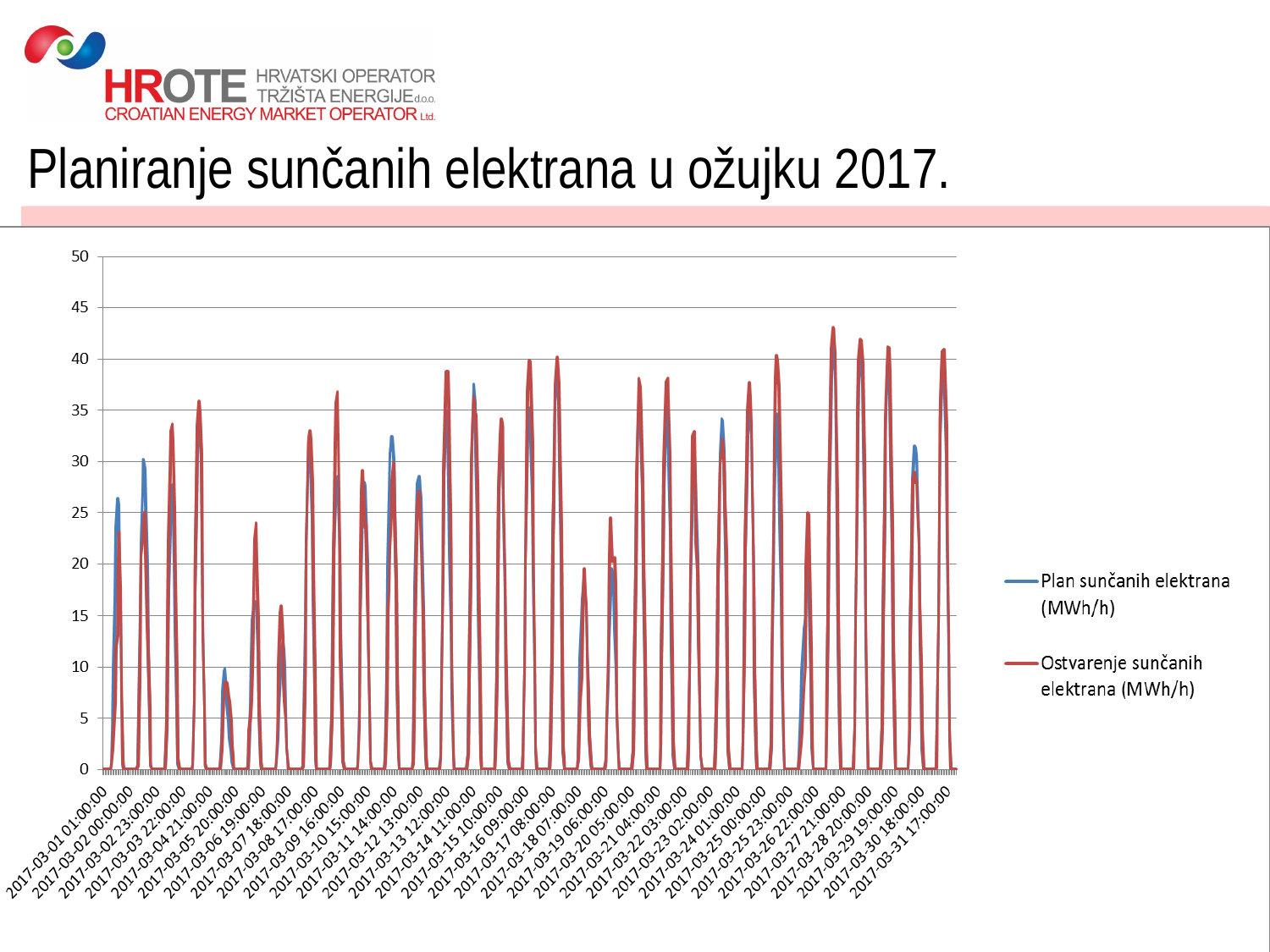
Does any value in the chart exceed 45? No Is the peak near 2017-03-19 greater or less than 25? less What unit is used for both series in the legend? MWh/h Is the first peak of the 'Plan sunčanih elektrana (MWh/h)' series (around 2017-03-01) greater or less than 20? greater What is the maximum value shown on the y axis? 50 What kind of chart is shown on the slide? Line chart How many series does the legend list? 2 What is the title of the slide chart? Planiranje sunčanih elektrana u ožujku 2017.